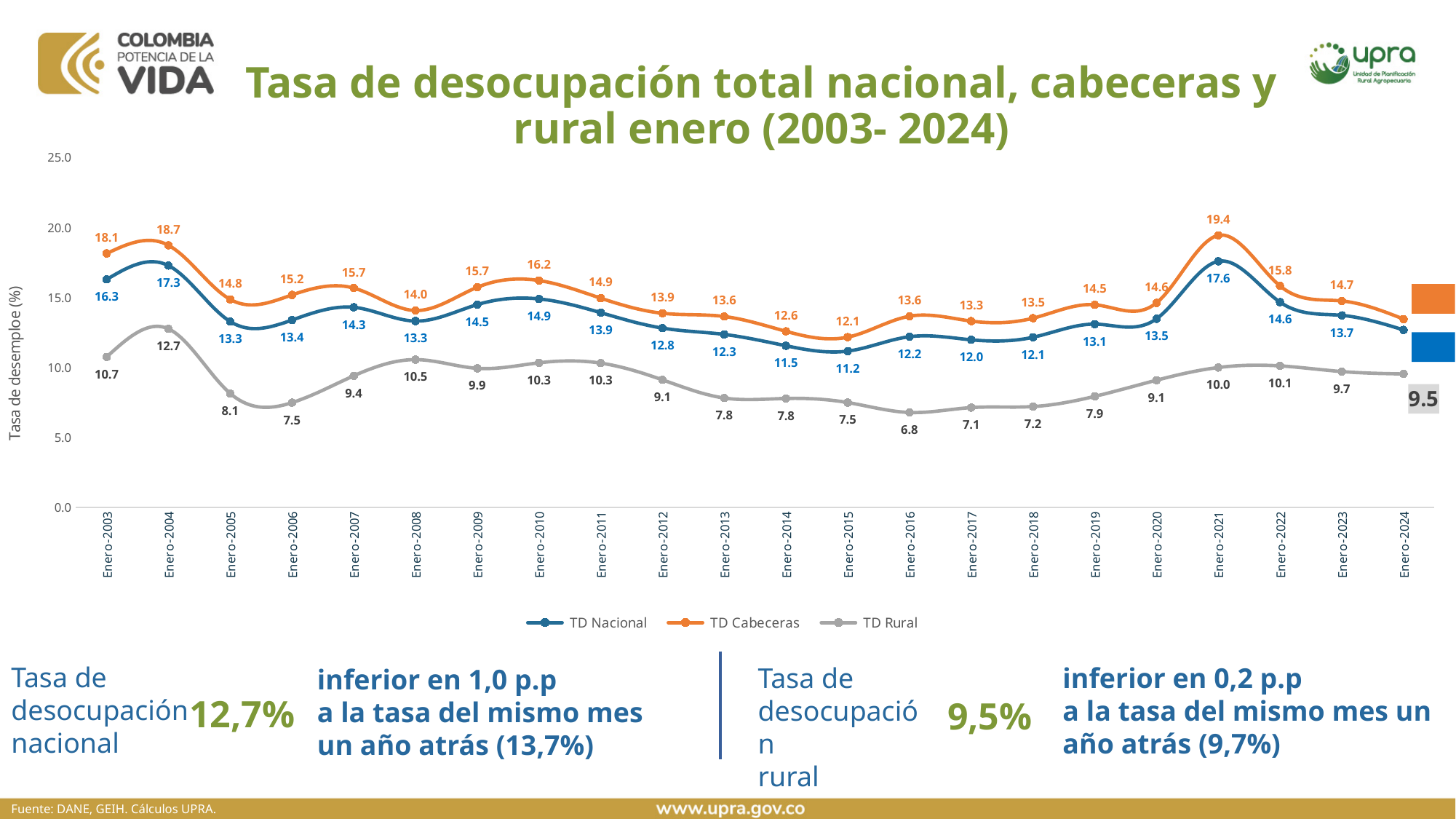
In which year does TD Rural reach its highest value? Enero-2004 What is the value of TD Nacional in Enero-2015? 11.2 How many points (years) are plotted along the x axis? 22 What is the value of TD Cabeceras in Enero-2021? 19.4 What is the difference between TD Cabeceras and TD Nacional in Enero-2021? 1.8 How many series does the legend list? 3 In which year does TD Rural reach its lowest value? Enero-2016 What is the value of TD Rural in Enero-2024? 9.5 Which is larger: TD Rural in Enero-2008 or TD Rural in Enero-2009? Enero-2008 Is the value for TD Cabeceras in Enero-2024 greater or less than 15.0? less In which year does TD Cabeceras reach its highest value? Enero-2021 What kind of chart is shown on the slide? line chart